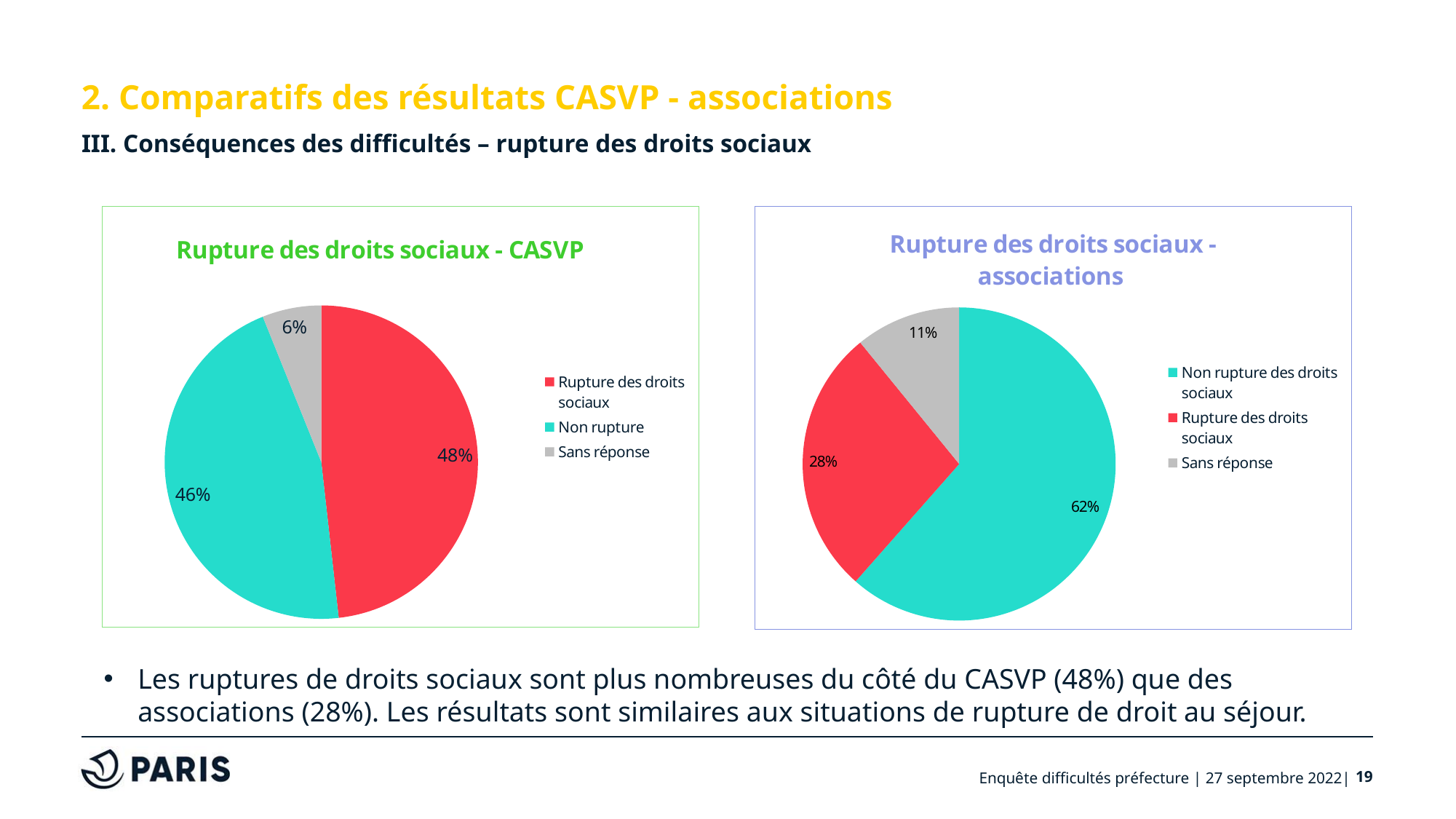
In the 'Rupture des droits sociaux - CASVP' pie chart, what share is 'Non rupture'? 46% In the 'Rupture des droits sociaux - associations' pie chart, which category has the largest share? Non rupture des droits sociaux How many slices does the 'Rupture des droits sociaux - CASVP' pie chart have? 3 In the 'Rupture des droits sociaux - associations' pie chart, what share is 'Rupture des droits sociaux'? 28% In the 'Rupture des droits sociaux - CASVP' pie chart, what share is 'Rupture des droits sociaux'? 48% What type of chart is 'Rupture des droits sociaux - associations'? Pie chart In the 'Rupture des droits sociaux - CASVP' pie chart, what share is 'Sans réponse'? 6% In the 'Rupture des droits sociaux - associations' pie chart, what share is 'Sans réponse'? 11% In the 'Rupture des droits sociaux - associations' pie chart, what share is 'Non rupture des droits sociaux'? 62% In the 'Rupture des droits sociaux - CASVP' pie chart, which category has the smallest share? Sans réponse Which is larger: 'Sans réponse' in the CASVP chart or 'Sans réponse' in the associations chart? Associations chart What is the difference between the 'Rupture des droits sociaux' share in the CASVP chart and in the associations chart? 20 percentage points